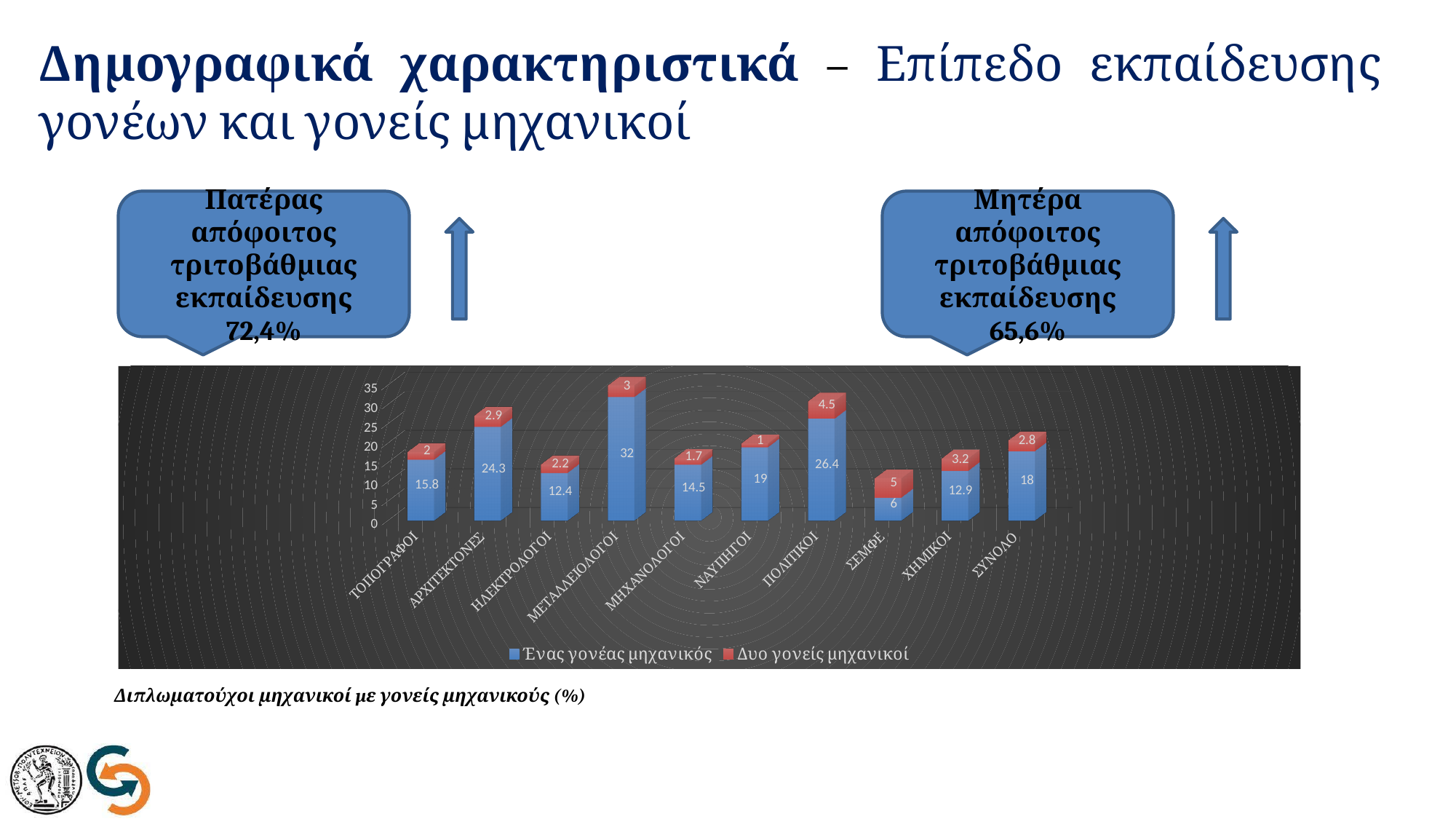
Which is larger: the 'Ένας γονέας μηχανικός' value for ΝΑΥΠΗΓΟΙ or for ΜΗΧΑΝΟΛΟΓΟΙ? ΝΑΥΠΗΓΟΙ Which category has the highest value for 'Δυο γονείς μηχανικοί'? ΣΕΜΦΕ How many categories are shown on the x axis? 10 What is the value of 'Δυο γονείς μηχανικοί' for ΠΟΛΙΤΙΚΟΙ? 4.5 What kind of chart is shown on the slide? Stacked bar chart How many series does the legend list? 2 What is the difference between the 'Ένας γονέας μηχανικός' values for ΑΡΧΙΤΕΚΤΟΝΕΣ and ΤΟΠΟΓΡΑΦΟΙ? 8.5 Which category has the lowest value for 'Ένας γονέας μηχανικός'? ΣΕΜΦΕ What is the value of 'Ένας γονέας μηχανικός' for ΣΥΝΟΛΟ? 18 What is the total of the stacked bar for ΠΟΛΙΤΙΚΟΙ? 30.9 Which category has the highest value for 'Ένας γονέας μηχανικός'? ΜΕΤΑΛΛΕΙΟΛΟΓΟΙ What is the value of 'Ένας γονέας μηχανικός' for ΜΕΤΑΛΛΕΙΟΛΟΓΟΙ? 32